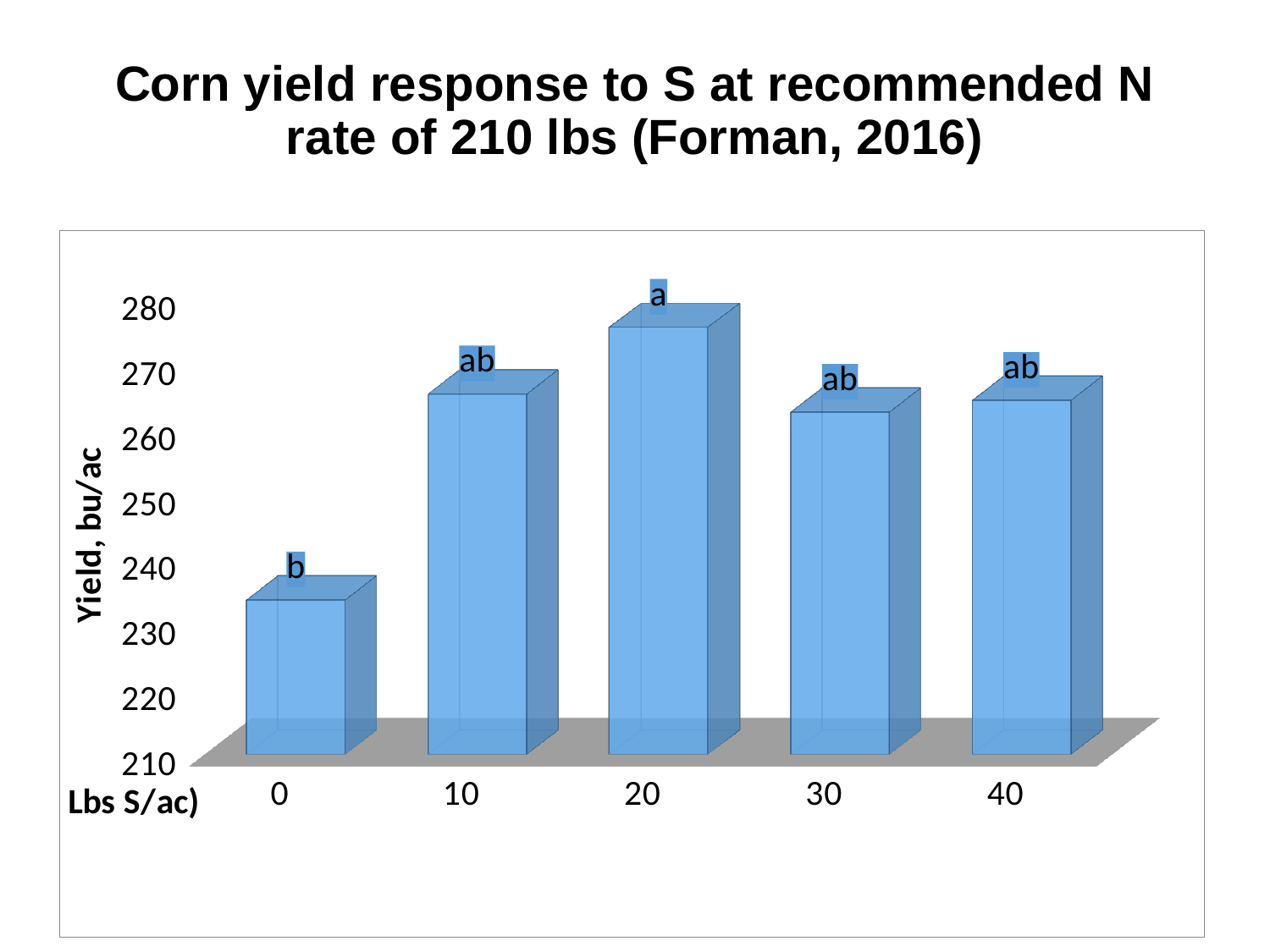
What is the label on the y axis of the chart? Yield, bu/ac What kind of chart is shown on the slide? bar chart Which has the larger yield, the 0 Lbs S/ac rate or the 30 Lbs S/ac rate? 30 Lbs S/ac What letter label is shown above the bar for the 20 Lbs S/ac rate? a Is the yield for the 20 Lbs S/ac rate greater or less than 270? greater Is the yield for the 10 Lbs S/ac rate greater or less than 260? greater Is the yield for the 30 Lbs S/ac rate greater or less than 270? less Which S rate (Lbs S/ac) has the lowest corn yield? 0 How many S rate categories are plotted on the x axis? 5 Which has the larger yield, the 20 Lbs S/ac rate or the 40 Lbs S/ac rate? 20 Lbs S/ac Which S rate (Lbs S/ac) has the highest corn yield? 20